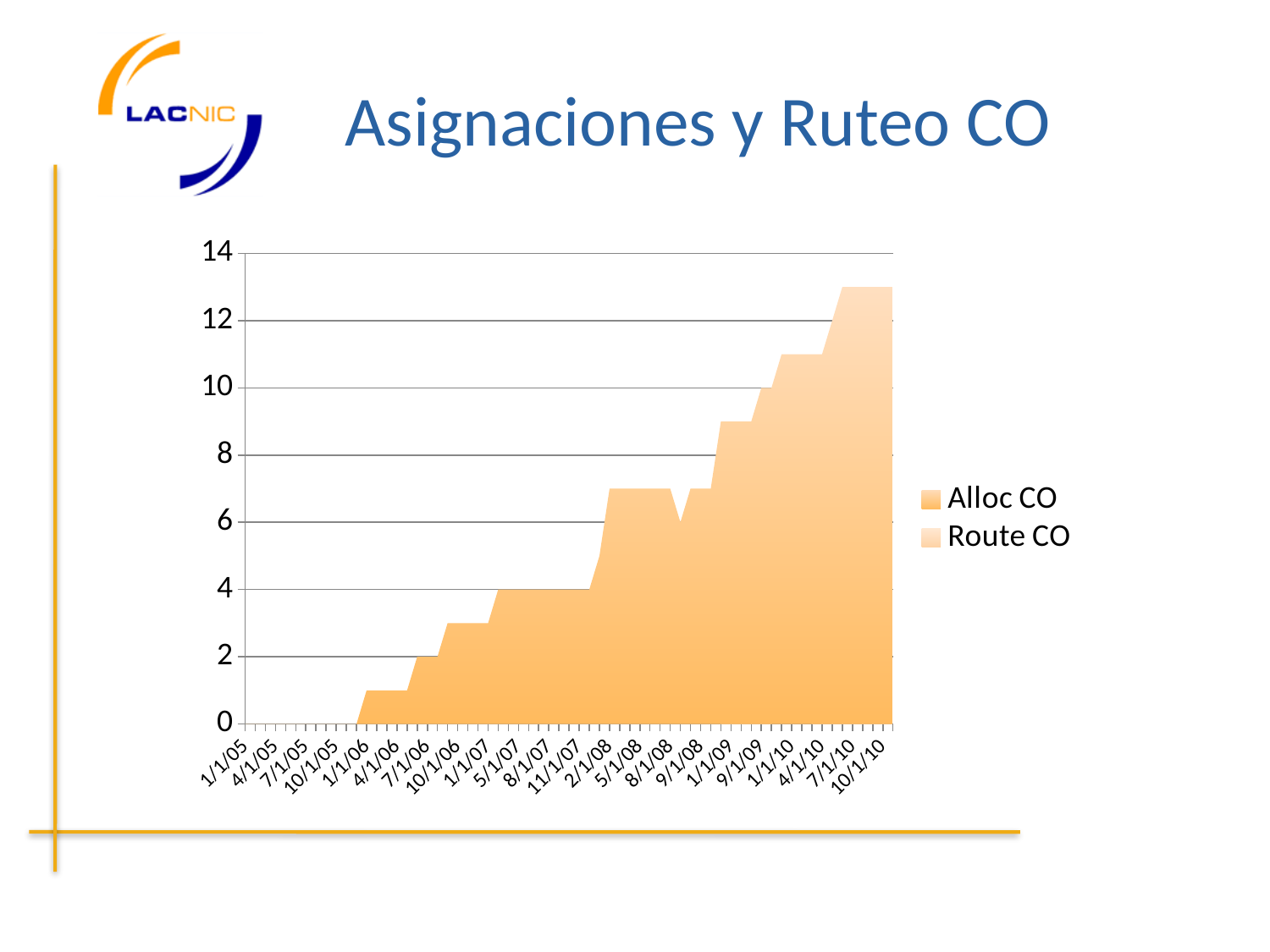
Is the plotted value at 1/1/07 greater or less than 4? less What kind of chart is shown on the slide? area chart Is the plotted value at 5/1/08 greater or less than 6? greater Is the plotted value at 4/1/06 greater or less than 2? less Which date has the higher plotted value, 1/1/05 or 10/1/10? 10/1/10 Do the plotted values generally rise or fall from 1/1/05 to 10/1/10? rise What is the title of the slide containing the chart? Asignaciones y Ruteo CO What is the highest value shown on the vertical axis? 14 How many series does the legend list? 2 What are the two series named in the legend? Alloc CO and Route CO